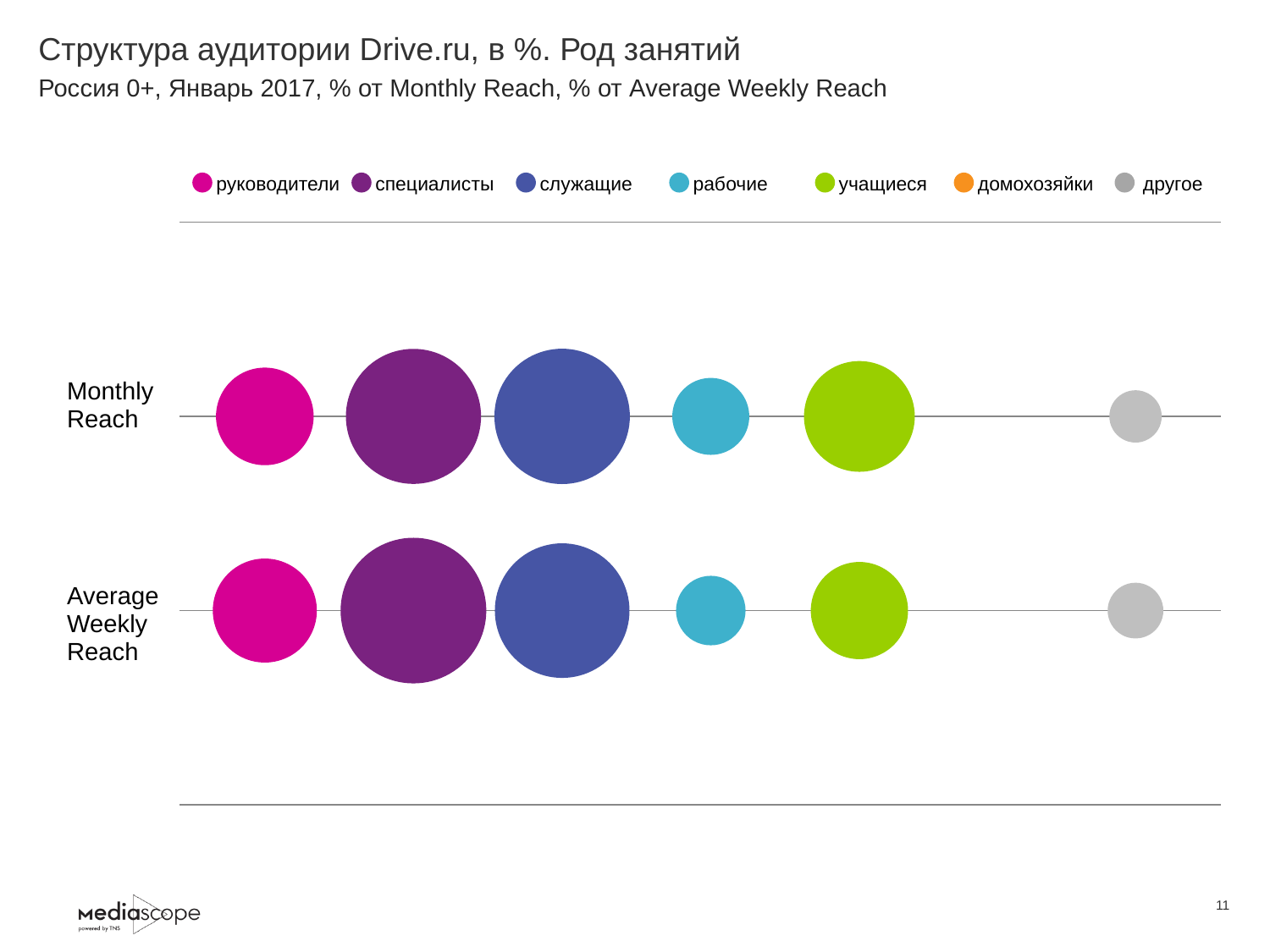
In the Monthly Reach row, which bubble is larger: специалисты or руководители? специалисты In the Monthly Reach row, which bubble is larger: рабочие or другое? рабочие Which occupation group has the largest bubble in the Average Weekly Reach row? специалисты How many rows (reach categories) are plotted on the chart? 2 What kind of chart is shown on the slide? bubble chart What is the title of the slide? Структура аудитории Drive.ru, в %. Род занятий In the Average Weekly Reach row, which bubble is larger: руководители or рабочие? руководители How many series does the legend list? 7 What colour represents учащиеся in the legend? green